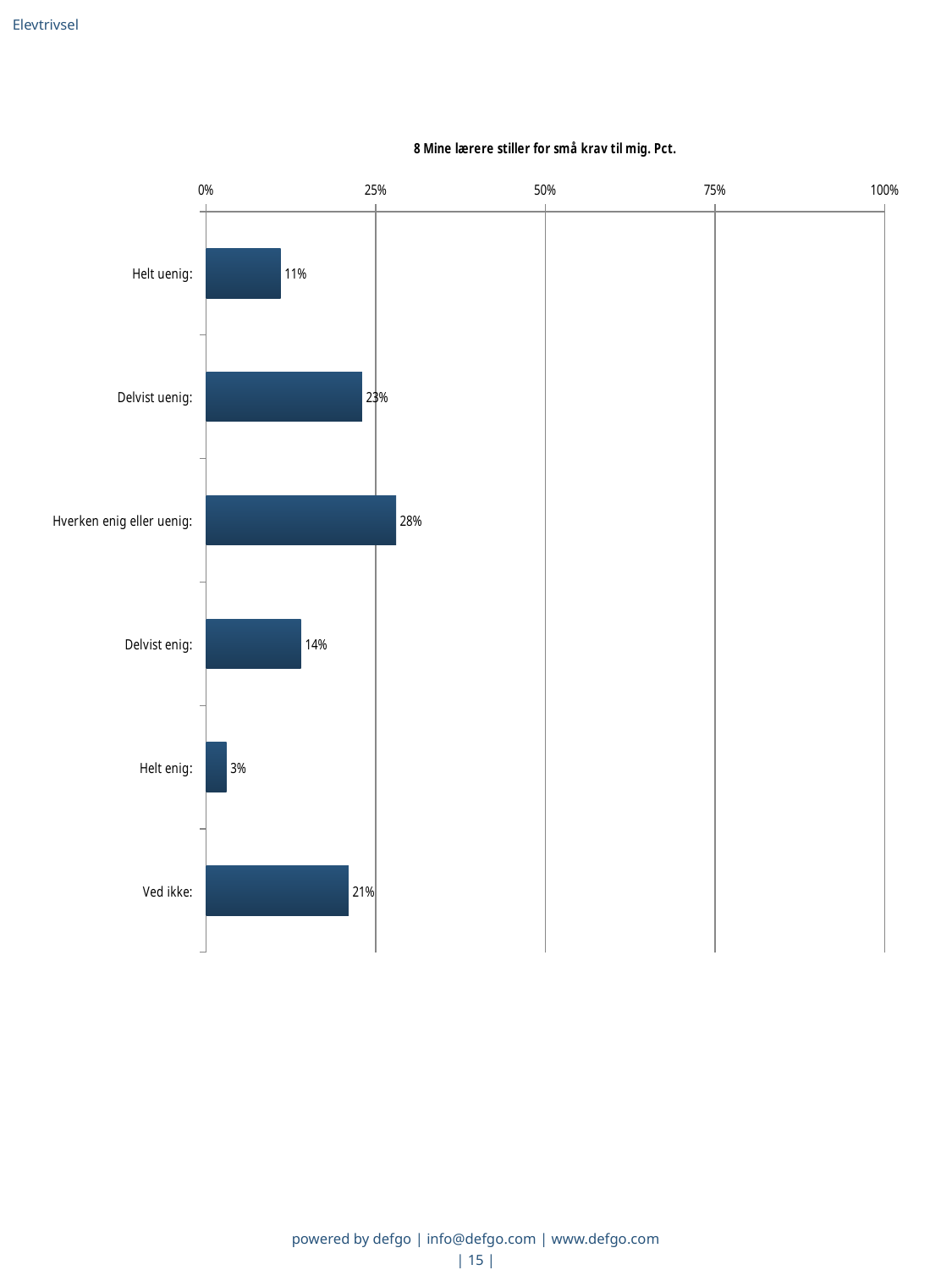
Which is larger, the value for Helt uenig or the value for Ved ikke? Ved ikke Is the value for Hverken enig eller uenig greater or less than 25%? greater What is the value for Helt uenig? 11% What is the difference between the values for Delvist uenig and Delvist enig? 9% Which category has the lowest value? Helt enig How many categories are shown in the chart? 6 What is the value for Delvist uenig? 23% Which category has the highest value? Hverken enig eller uenig What kind of chart is shown on the slide? bar chart What is the title of the chart? 8 Mine lærere stiller for små krav til mig. Pct. What is the value for Ved ikke? 21% What is the value for Hverken enig eller uenig? 28%